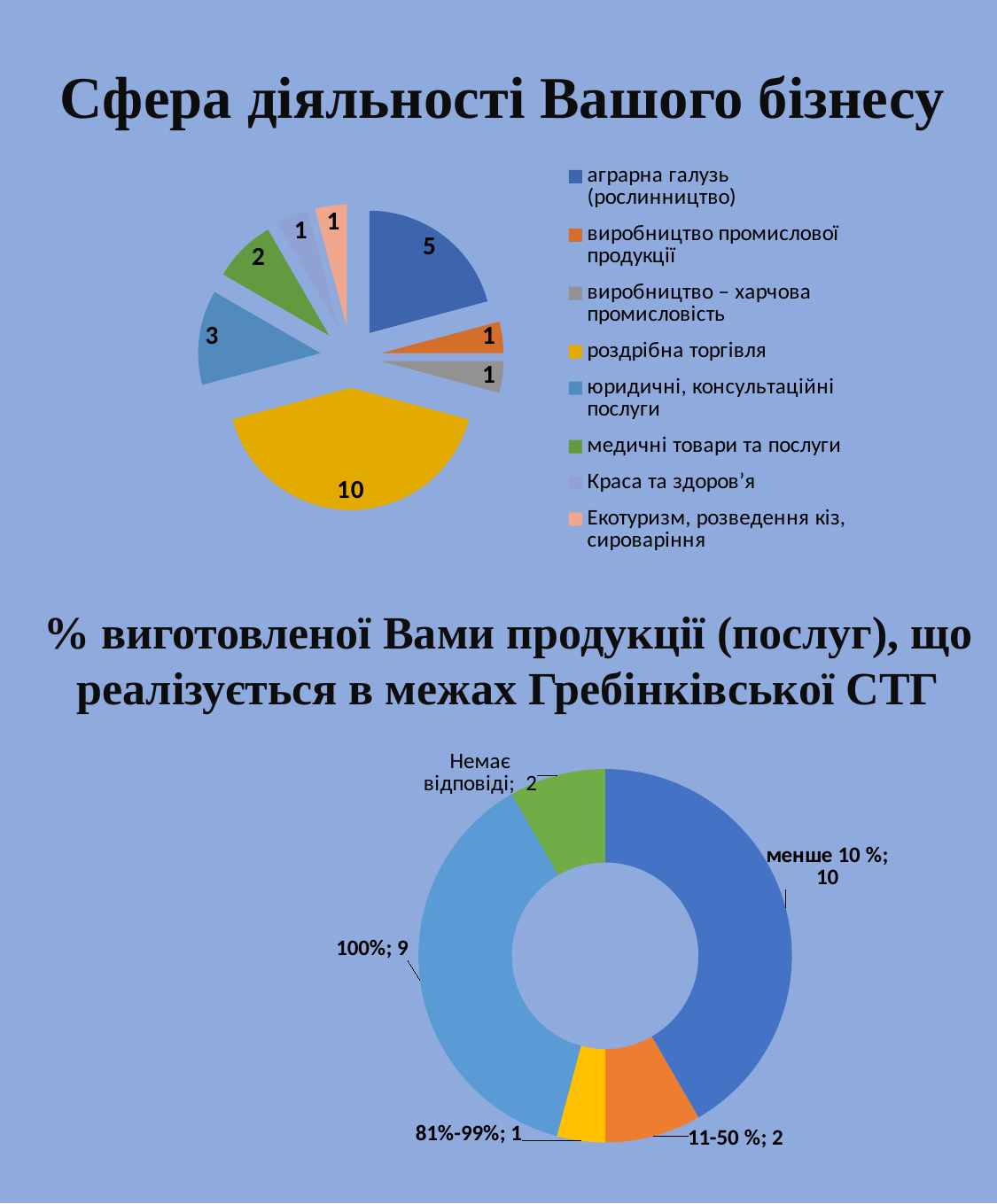
What kind of chart is '% виготовленої Вами продукції (послуг), що реалізується в межах Гребінківської СТГ'? doughnut chart In the chart 'Сфера діяльності Вашого бізнесу', which is larger: 'медичні товари та послуги' or 'юридичні, консультаційні послуги'? юридичні, консультаційні послуги In the chart '% виготовленої Вами продукції (послуг), що реалізується в межах Гребінківської СТГ', what is the difference between 'менше 10 %' and '11-50 %'? 8 In the chart 'Сфера діяльності Вашого бізнесу', which category has the highest value? роздрібна торгівля In the chart '% виготовленої Вами продукції (послуг), що реалізується в межах Гребінківської СТГ', what share of the total does '100%' represent? 37.5% In the chart 'Сфера діяльності Вашого бізнесу', what is the value for 'юридичні, консультаційні послуги'? 3 In the chart 'Сфера діяльності Вашого бізнесу', what is the value for 'роздрібна торгівля'? 10 In the chart 'Сфера діяльності Вашого бізнесу', what is the difference between 'роздрібна торгівля' and 'аграрна галузь (рослинництво)'? 5 In the chart '% виготовленої Вами продукції (послуг), що реалізується в межах Гребінківської СТГ', what is the value for '100%'? 9 What kind of chart is 'Сфера діяльності Вашого бізнесу'? pie chart How many categories does the legend of the chart 'Сфера діяльності Вашого бізнесу' list? 8 In the chart '% виготовленої Вами продукції (послуг), що реалізується в межах Гребінківської СТГ', which category has the lowest value? 81%-99%